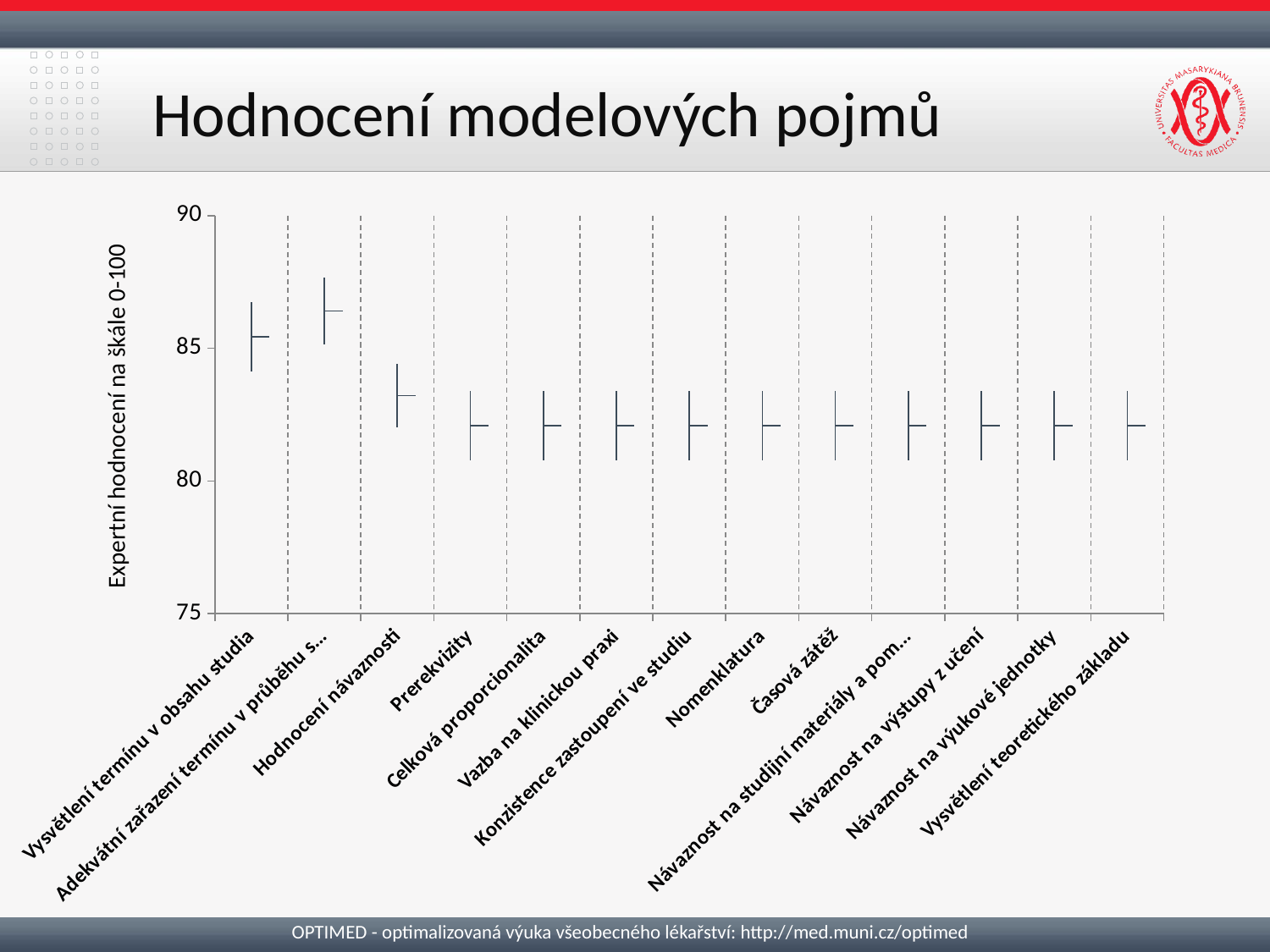
Is the value for Vysvětlení termínu v obsahu studia greater or less than 85? greater Is the value for Nomenklatura greater or less than 80? greater Which category has the highest value in the chart? Adekvátní zařazení termínu v průběhu s... What is the title of the chart on the slide? Hodnocení modelových pojmů Is the value for Prerekvizity greater or less than 85? less Do the values generally rise or fall moving from left to right along the x axis? fall How many categories are shown on the x axis of the chart? 13 Which has the larger value, Hodnocení návaznosti or Prerekvizity? Hodnocení návaznosti Which has the larger value, Adekvátní zařazení termínu v průběhu s... or Vysvětlení teoretického základu? Adekvátní zařazení termínu v průběhu s... What is the label of the vertical axis of the chart? Expertní hodnocení na škále 0-100